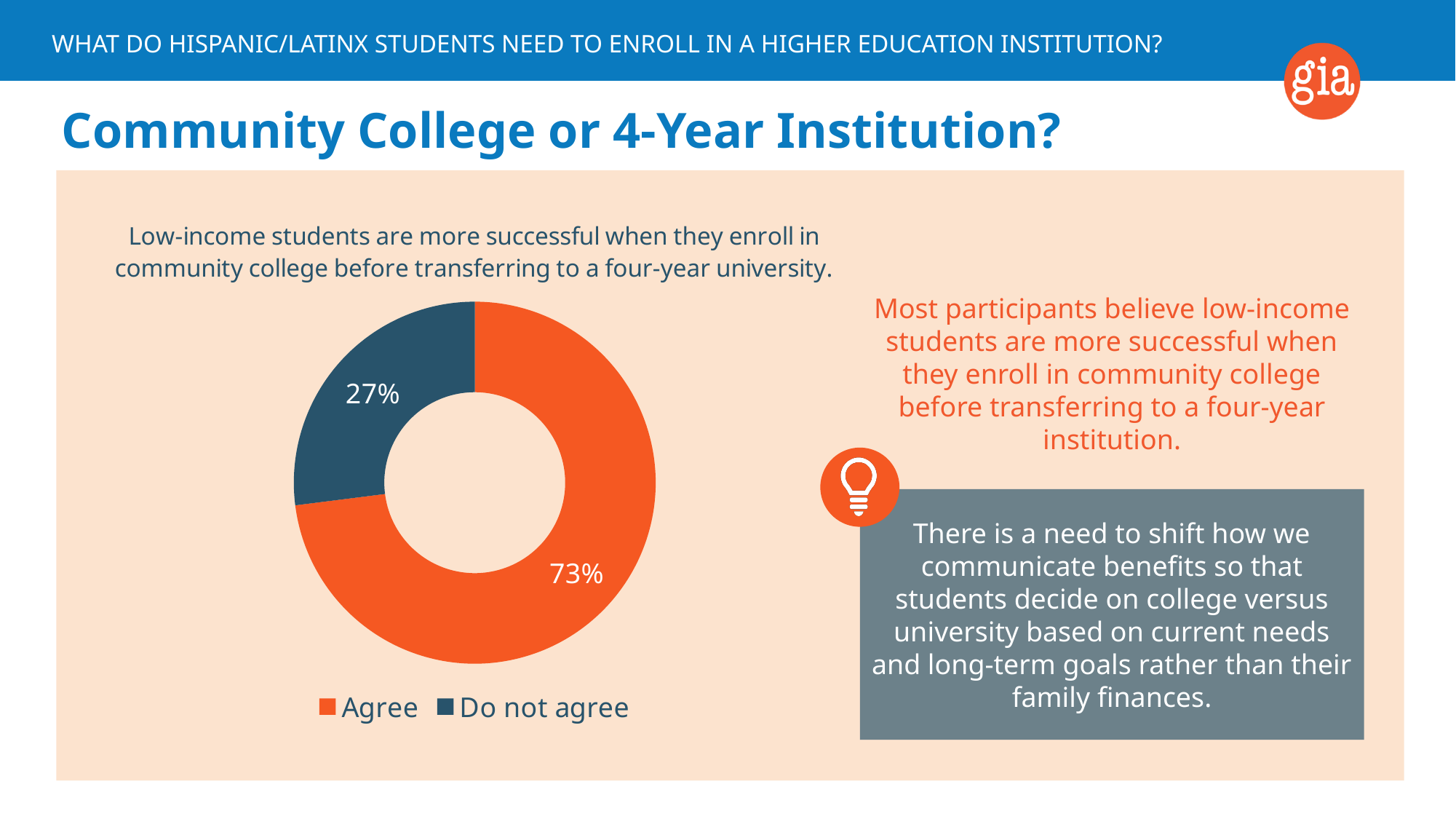
What statement is the chart about, as shown in the text above it? Low-income students are more successful when they enroll in community college before transferring to a four-year university. Is the share for Do not agree larger or smaller than the share for Agree? smaller What is the difference in percentage points between the Agree and Do not agree shares? 46 How many entries does the chart legend list? 2 What percentage of participants agree that low-income students are more successful when they enroll in community college before transferring to a four-year university? 73% What kind of chart is shown on the slide? Doughnut (pie) chart Which response has the smallest share of the chart? Do not agree What share of the chart does the Agree slice represent? 73% What percentage of participants do not agree with the statement about low-income students and community college? 27% What colour is the Agree slice in the chart? Orange Which response has the larger share of the chart, Agree or Do not agree? Agree How many categories does the chart show? 2